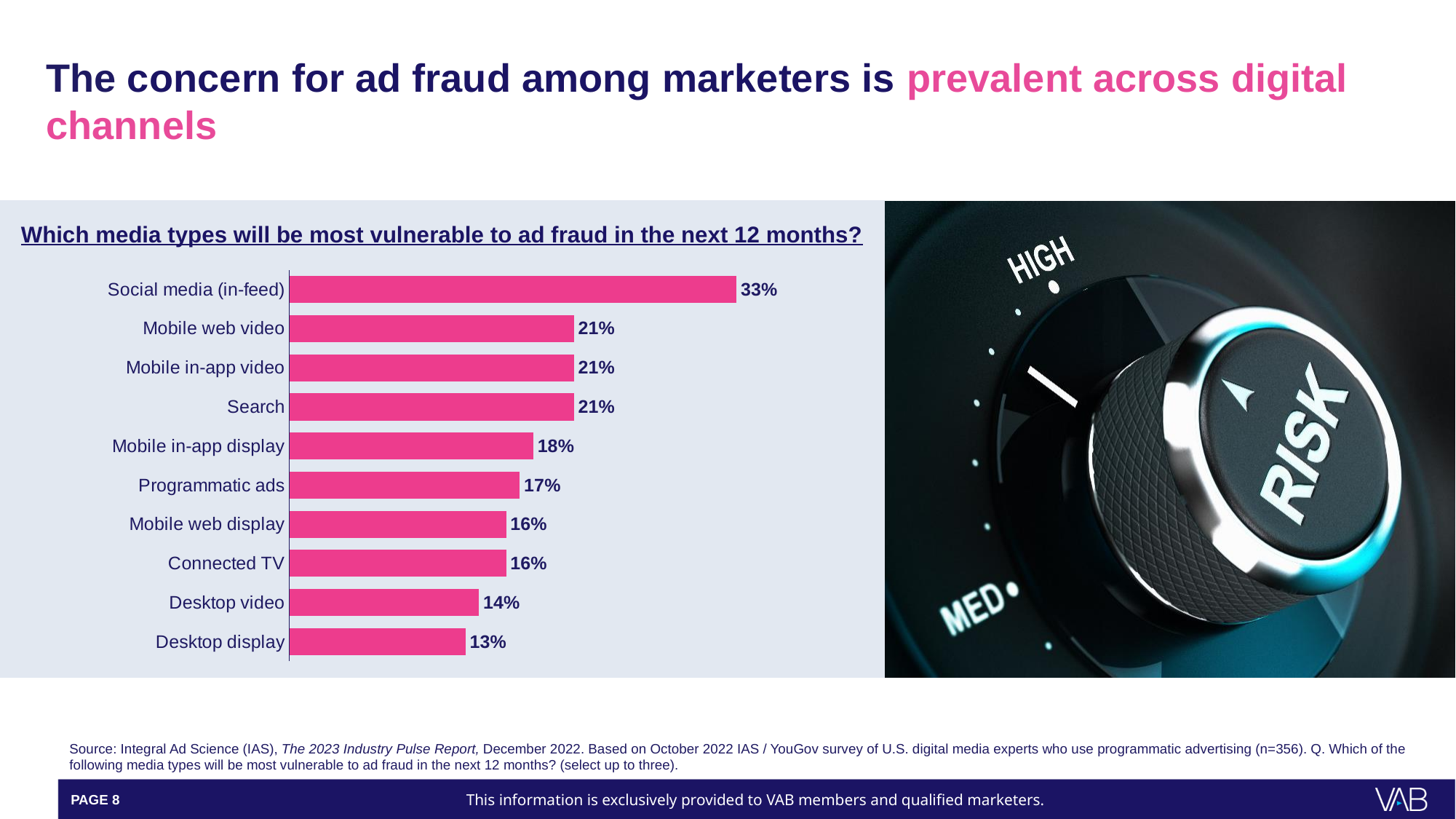
What percentage of respondents selected Social media (in-feed) as most vulnerable to ad fraud? 33% What is the difference between the values for Search and Mobile in-app display? 3 percentage points How many media types are shown in the chart? 10 What is the value shown for Connected TV? 16% Which media type has the highest value in the chart? Social media (in-feed) Which media type has the lowest value in the chart? Desktop display How many media types share the value of 21%? 3 What kind of chart is shown on the slide? Bar chart What is the value shown for Programmatic ads? 17% Which has a larger value, Mobile web video or Desktop video? Mobile web video What is the difference between the values for Social media (in-feed) and Desktop display? 20 percentage points What question does the chart title ask? Which media types will be most vulnerable to ad fraud in the next 12 months?